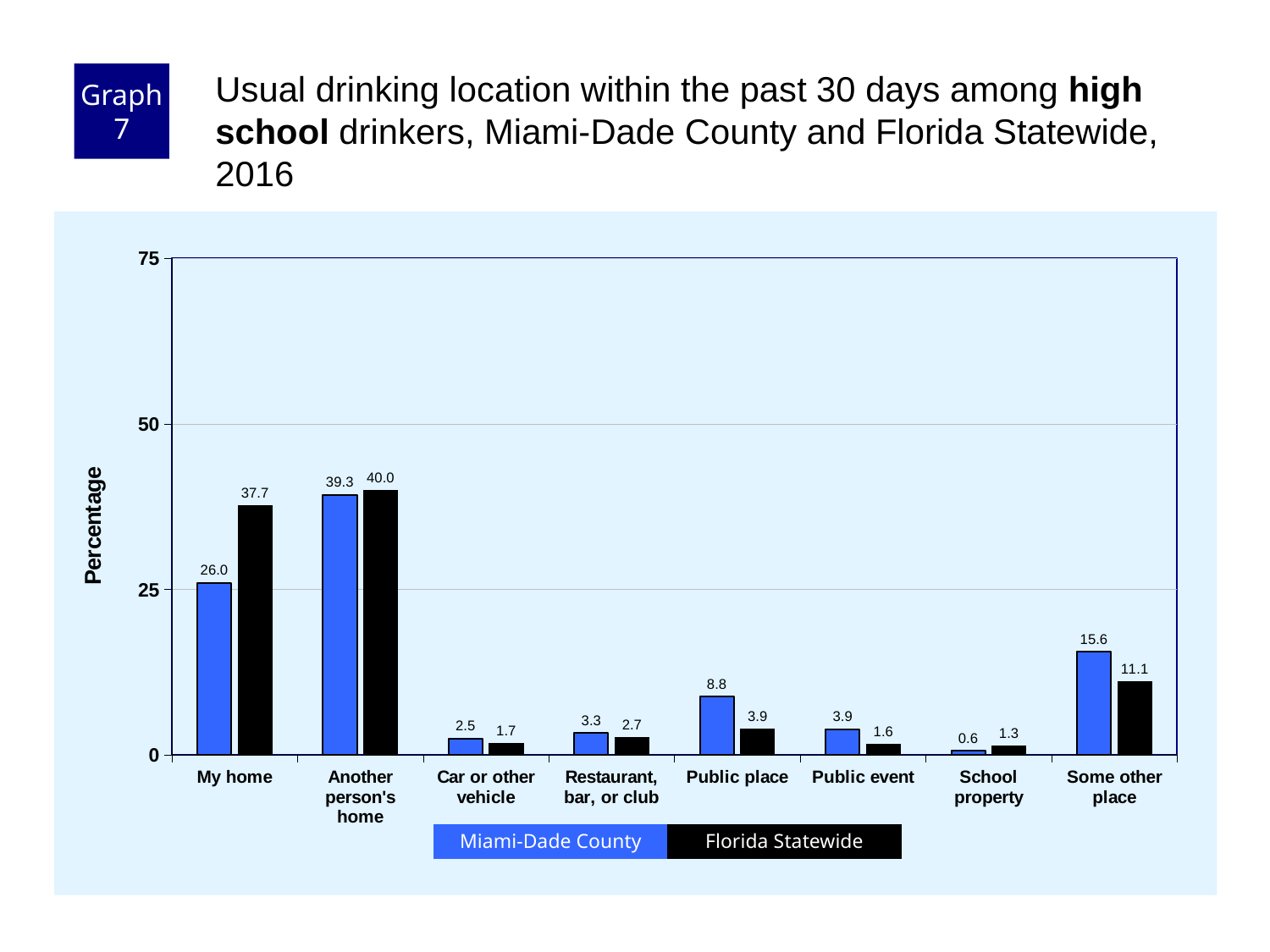
What kind of chart is shown on the slide? Bar chart How many location categories are shown on the x axis? 8 Which is larger for "Public event": Miami-Dade County or Florida Statewide? Miami-Dade County Which category has the highest Florida Statewide value? Another person's home What is the Miami-Dade County value for "Public place"? 8.8 What is the Miami-Dade County value for "My home"? 26.0 Which category has the lowest Miami-Dade County value? School property What is the difference between the Florida Statewide and Miami-Dade County values for "My home"? 11.7 Which colour represents Florida Statewide in the legend? Black What is the label of the y axis? Percentage What is the Florida Statewide value for "Some other place"? 11.1 How many series does the legend list? 2